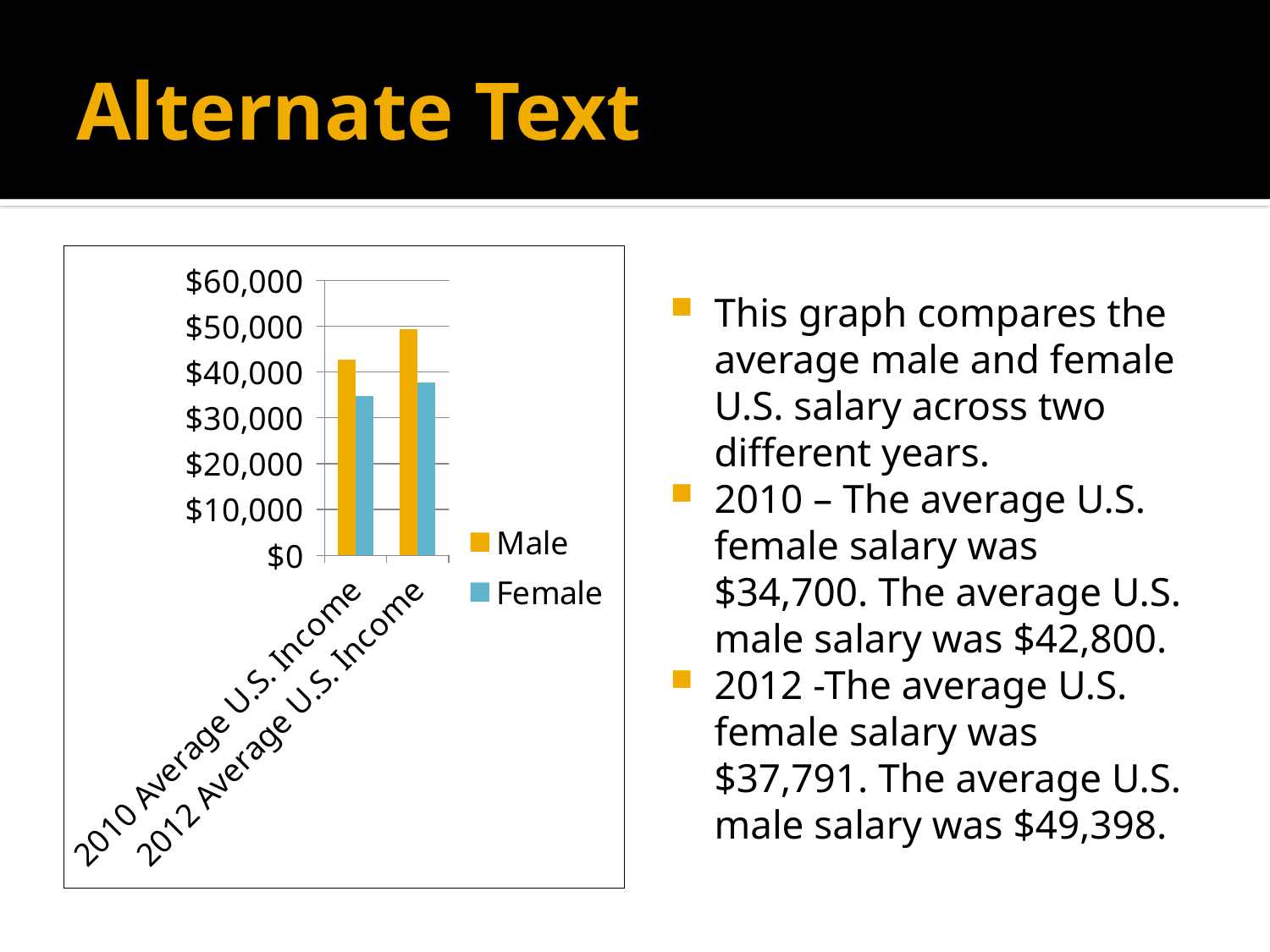
What kind of chart is shown on the slide? bar chart Which series is shown in blue in the chart? Female Which is larger for 2012 Average U.S. Income, the Male value or the Female value? Male Is the Female value for 2010 Average U.S. Income greater or less than $40,000? less Is the Female value for 2012 Average U.S. Income greater or less than $30,000? greater Does the Female series rise or fall from 2010 Average U.S. Income to 2012 Average U.S. Income? rise Is the Male value for 2012 Average U.S. Income greater or less than $40,000? greater Which bar in the chart is the tallest? Male, 2012 Average U.S. Income How many series does the chart legend list? 2 Which series is shown in yellow in the chart? Male How many categories are shown on the x axis of the chart? 2